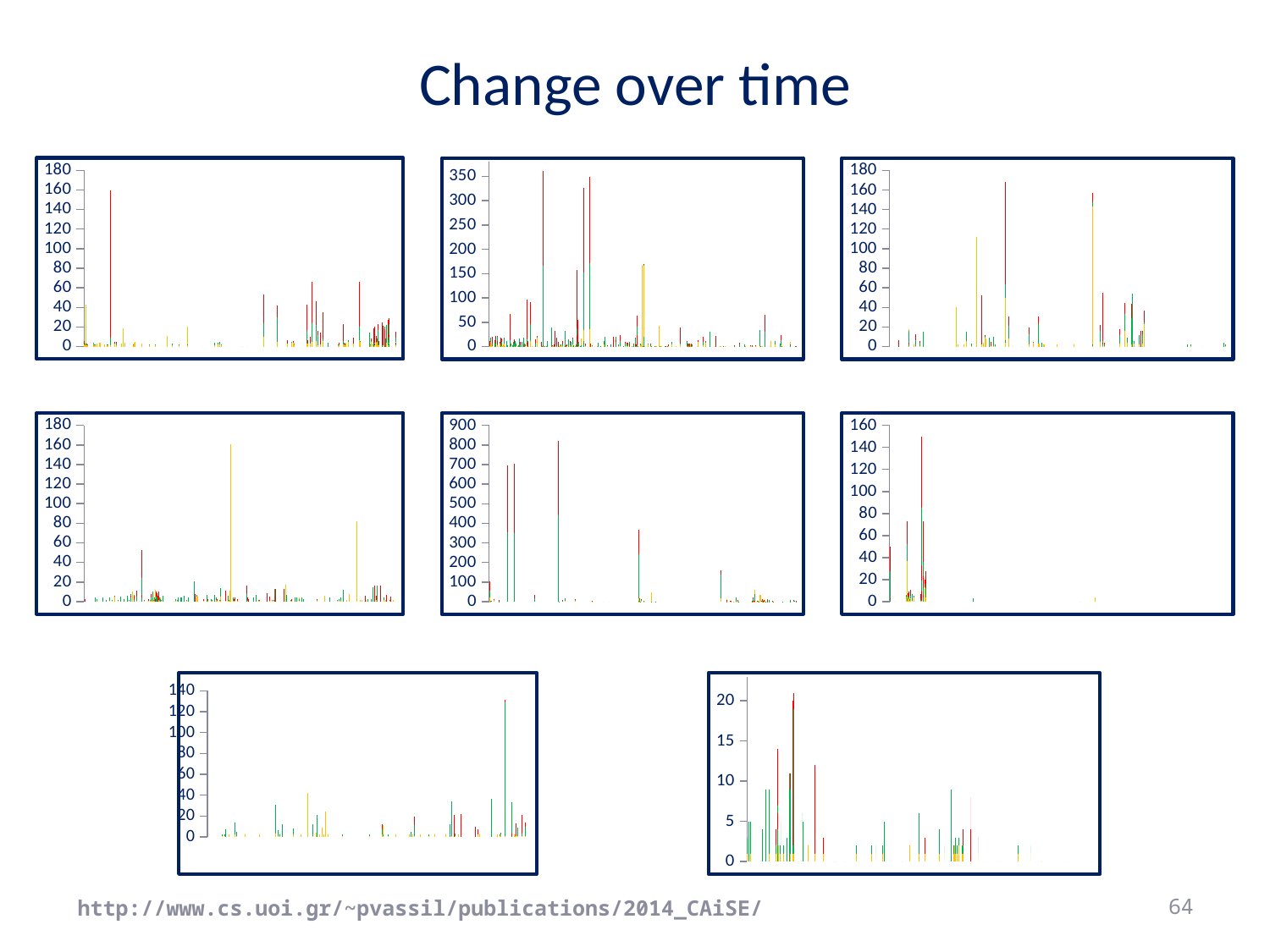
In the top-middle chart, is the value of the tallest bar greater or less than 300? greater What kind of chart is the bottom-right chart on the slide? bar chart What is the highest value labelled on the y axis of the middle chart in the middle row? 900 In the bottom-right chart, is the value of the tallest bar greater or less than 15? greater In the top-right chart, is the value of the tallest bar greater or less than 140? greater How many charts are shown on the slide? 8 What kind of chart is the top-left chart on the slide? bar chart